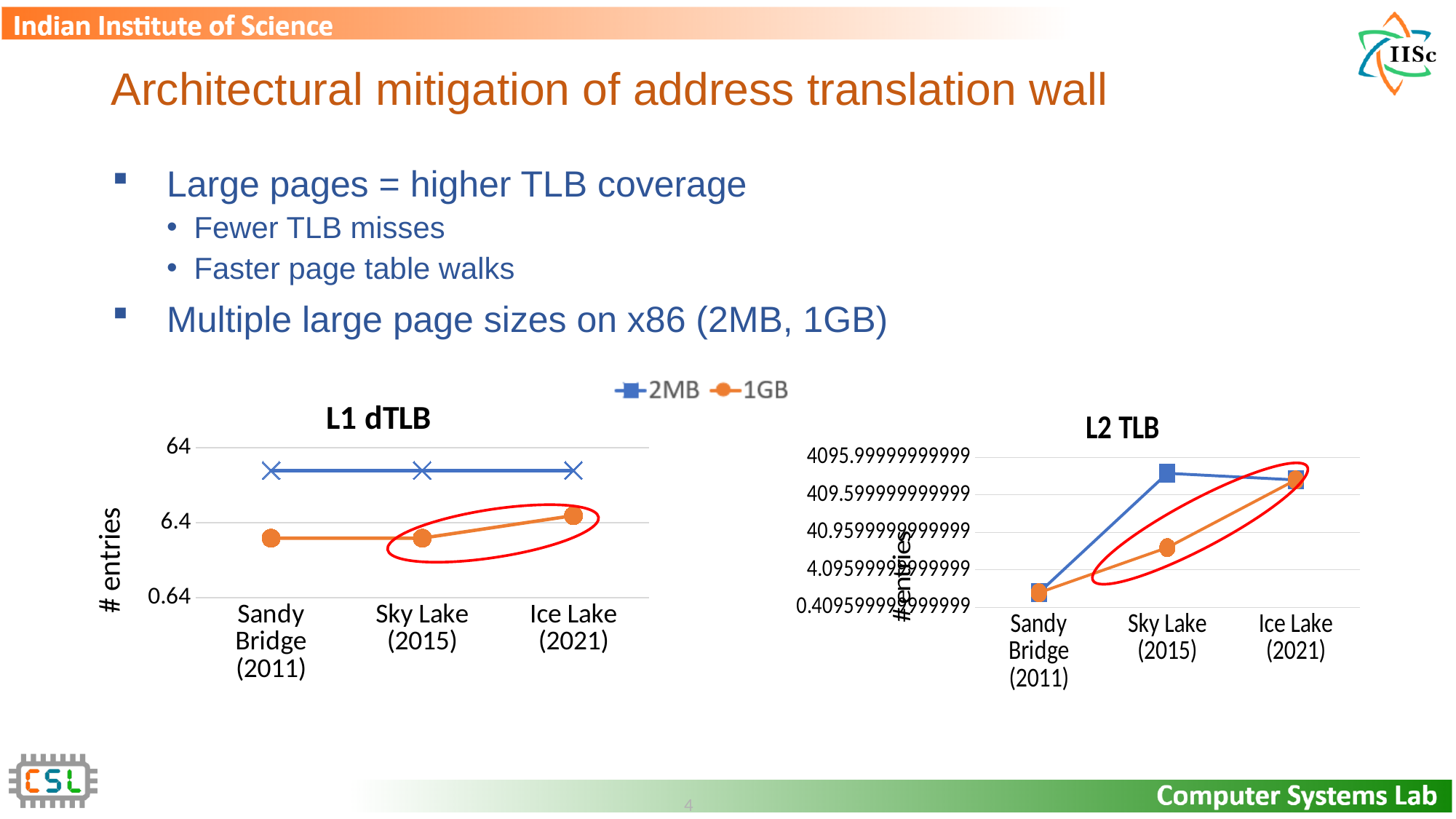
In the L1 dTLB chart, is the 1GB value for Sandy Bridge (2011) greater or less than 6.4? less In the L1 dTLB chart, which series has the higher value at Ice Lake (2021), 2MB or 1GB? 2MB In the L1 dTLB chart, does the 2MB series rise, fall, or stay flat from Sandy Bridge (2011) to Ice Lake (2021)? stays flat In the L1 dTLB chart, how many processor generations are plotted along the x axis? 3 In the L2 TLB chart, is the 1GB value for Sky Lake (2015) greater or less than 40.959999999999? less In the L2 TLB chart, is the 2MB value for Sky Lake (2015) greater or less than 409.59999999999? greater In the L2 TLB chart, which series has the higher value at Sky Lake (2015), 2MB or 1GB? 2MB What is the title of the chart on the right side of the slide? L2 TLB What kind of chart is the L1 dTLB chart? line chart In the L2 TLB chart, does the 1GB series rise or fall from Sandy Bridge (2011) to Ice Lake (2021)? rises How many series does the legend list for the charts? 2